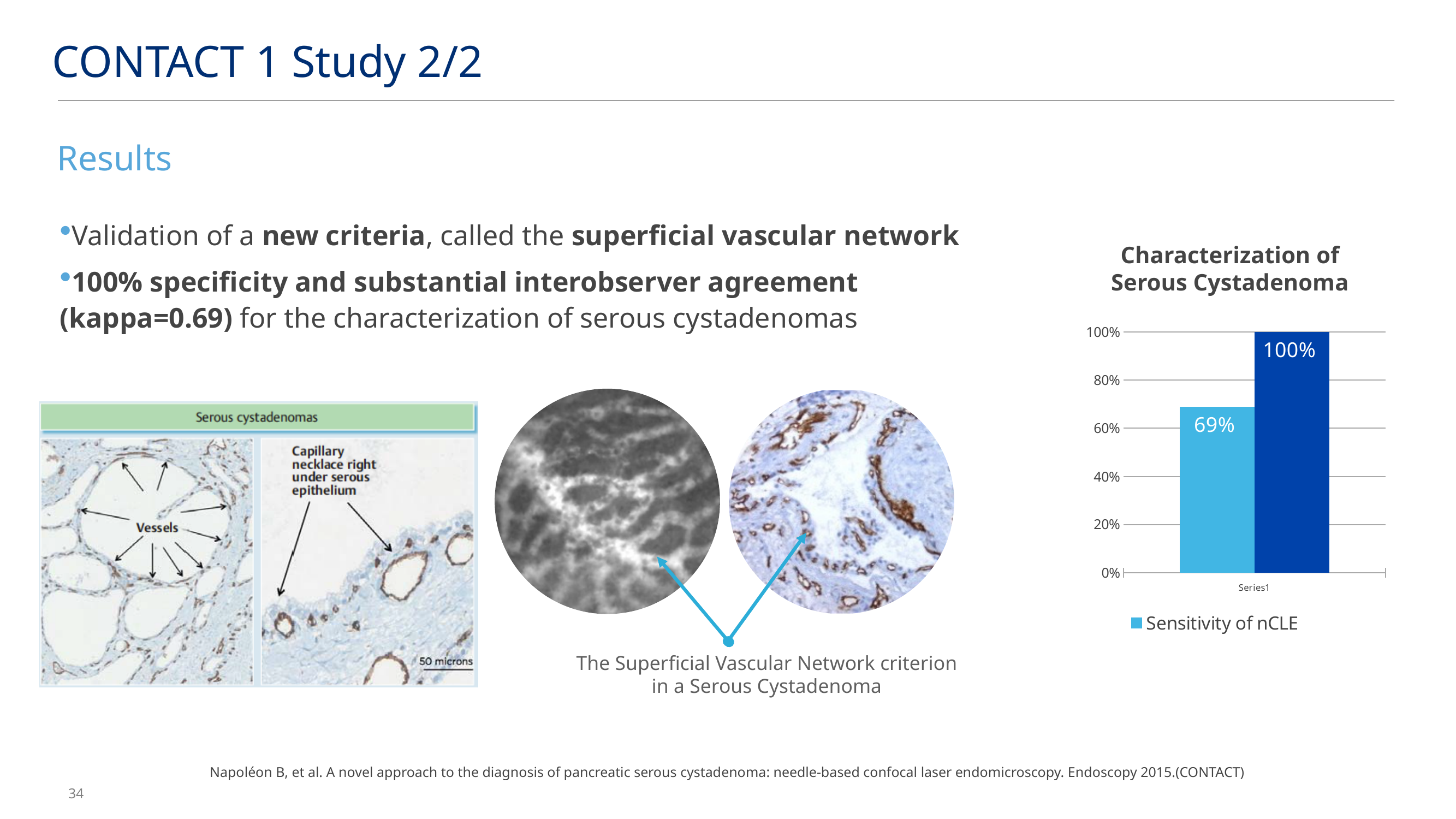
Which bar in the chart is the tallest? the dark blue bar (100%) How many entries does the chart's legend list? 1 What kind of chart is shown on the slide? bar chart Which is larger: the Sensitivity of nCLE bar or the dark blue bar? the dark blue bar What is the entry shown in the chart's legend? Sensitivity of nCLE What is the value of the Sensitivity of nCLE bar in the chart? 69% What value is printed on the dark blue bar in the chart? 100% What is the title of the chart? Characterization of Serous Cystadenoma Is the value for Sensitivity of nCLE greater or less than 80%? less How many bars are plotted in the chart? 2 Which bar in the chart is the shortest? Sensitivity of nCLE (69%) What is the difference between the dark blue bar (100%) and the Sensitivity of nCLE bar (69%)? 31%